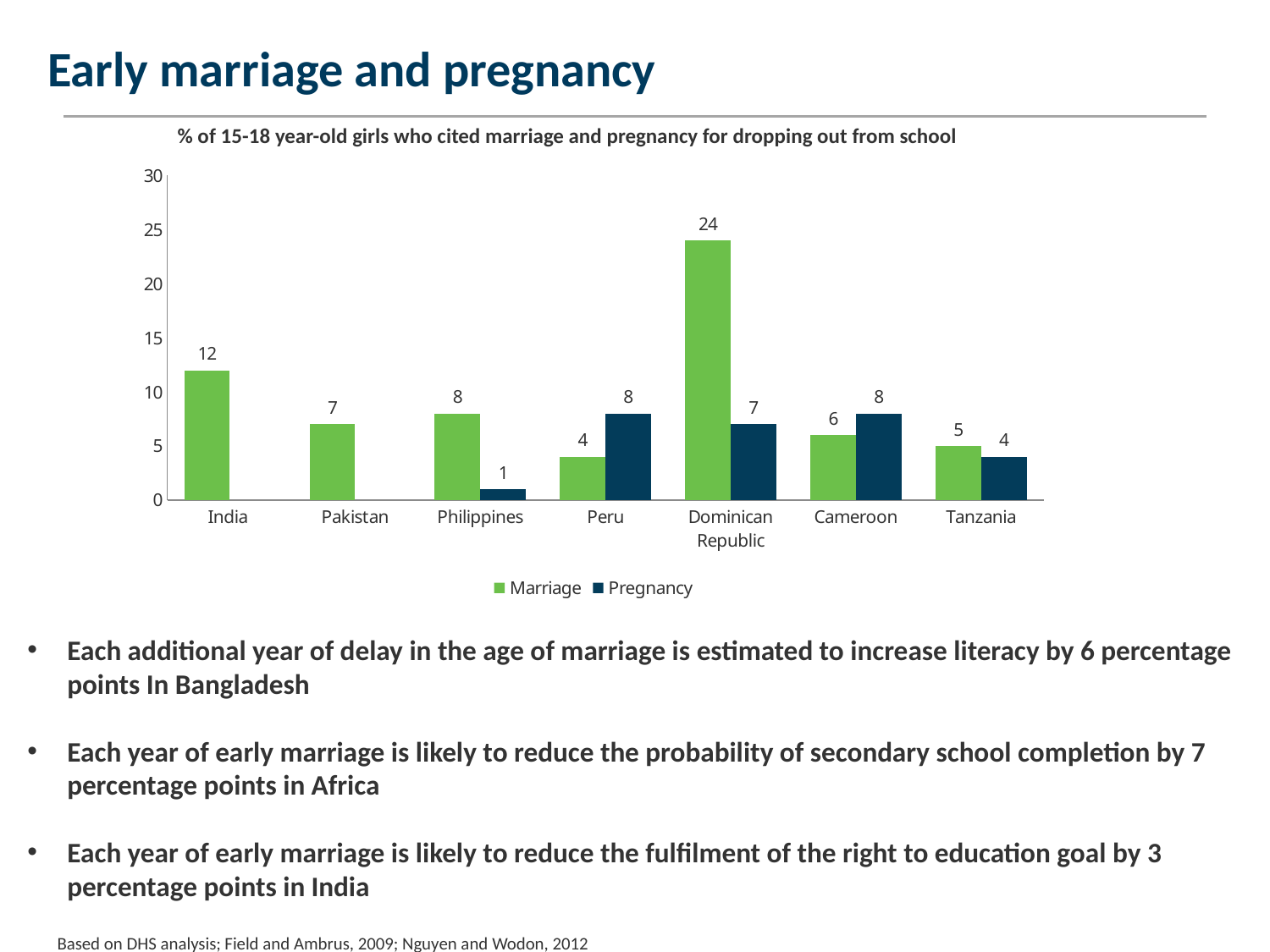
Which series is shown in green in the legend? Marriage How many countries are shown on the x axis? 7 What is the Marriage value for India? 12 What is the Marriage value for the Dominican Republic? 24 Is the Marriage value for the Dominican Republic greater or less than 20? greater What kind of chart is shown on the slide? bar chart Which country has the lowest Pregnancy value among those with a Pregnancy bar? Philippines What is the difference between the Marriage and Pregnancy values for the Dominican Republic? 17 How many series does the legend list? 2 Which country has the highest Marriage value? Dominican Republic What is the Pregnancy value for the Philippines? 1 Which is larger for Peru, the Marriage value or the Pregnancy value? Pregnancy